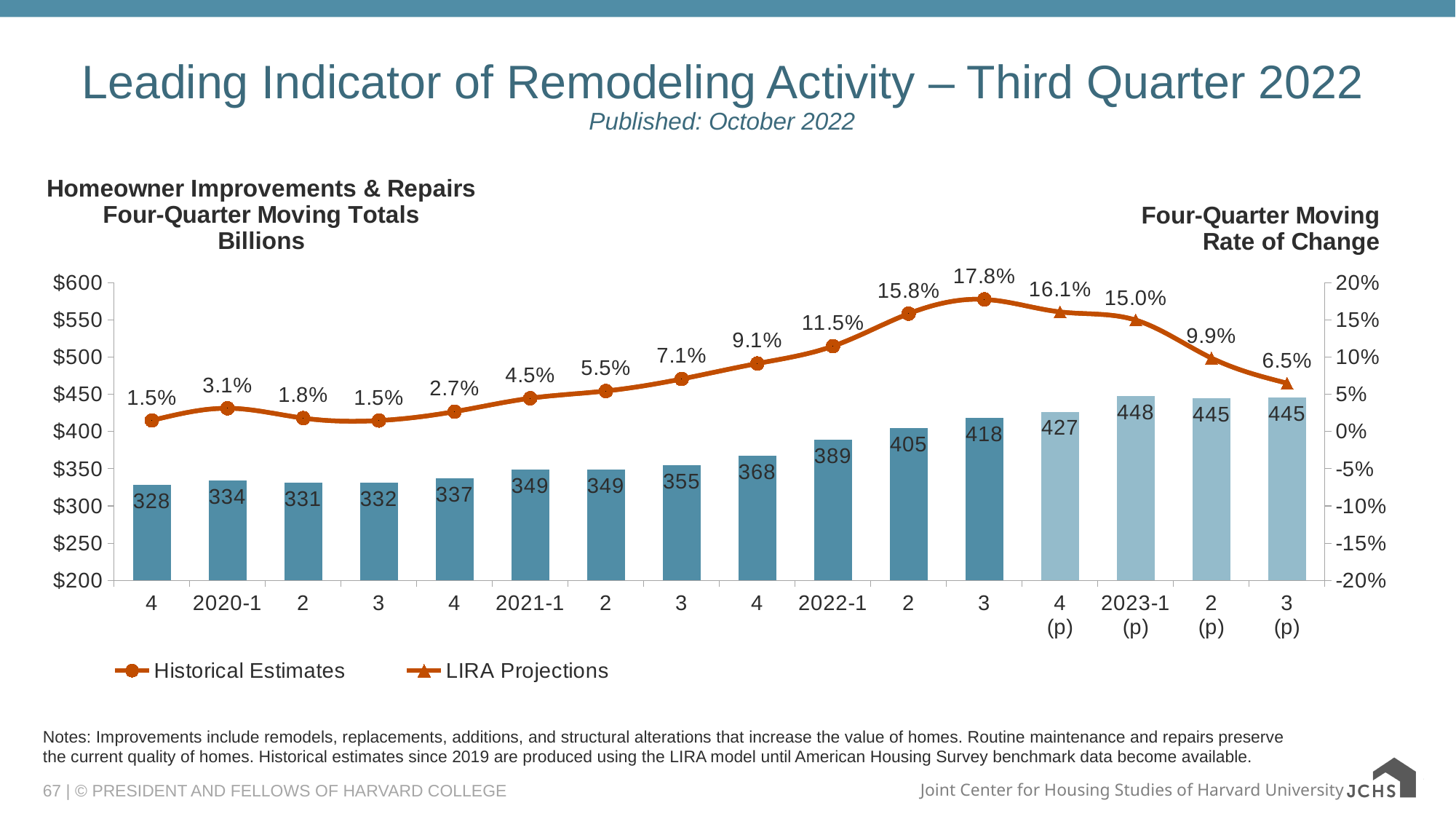
What is the projected four-quarter moving total for 2023-1 (p)? 448 Which quarter has the lowest four-quarter moving total bar? 2019-4 (the first bar, labeled 4) How many bars are plotted in the chart? 16 Which quarter has the highest four-quarter moving rate of change? 2022-3 What kind of chart is shown on the slide? Combined bar and line chart Which is larger, the rate of change for 2022-4 (p) or for 2023-1 (p)? 2022-4 (p) What is the four-quarter moving rate of change for 2022-1? 11.5% Does the four-quarter moving rate of change rise or fall from 2022-3 to 2023-3 (p)? Fall How many series does the legend list? 2 What is the four-quarter moving total (in billions) for 2022-3? 418 What is the difference between the four-quarter moving totals for 2023-1 (p) and 2022-3? 30 What are the two legend entries for the line series? Historical Estimates and LIRA Projections